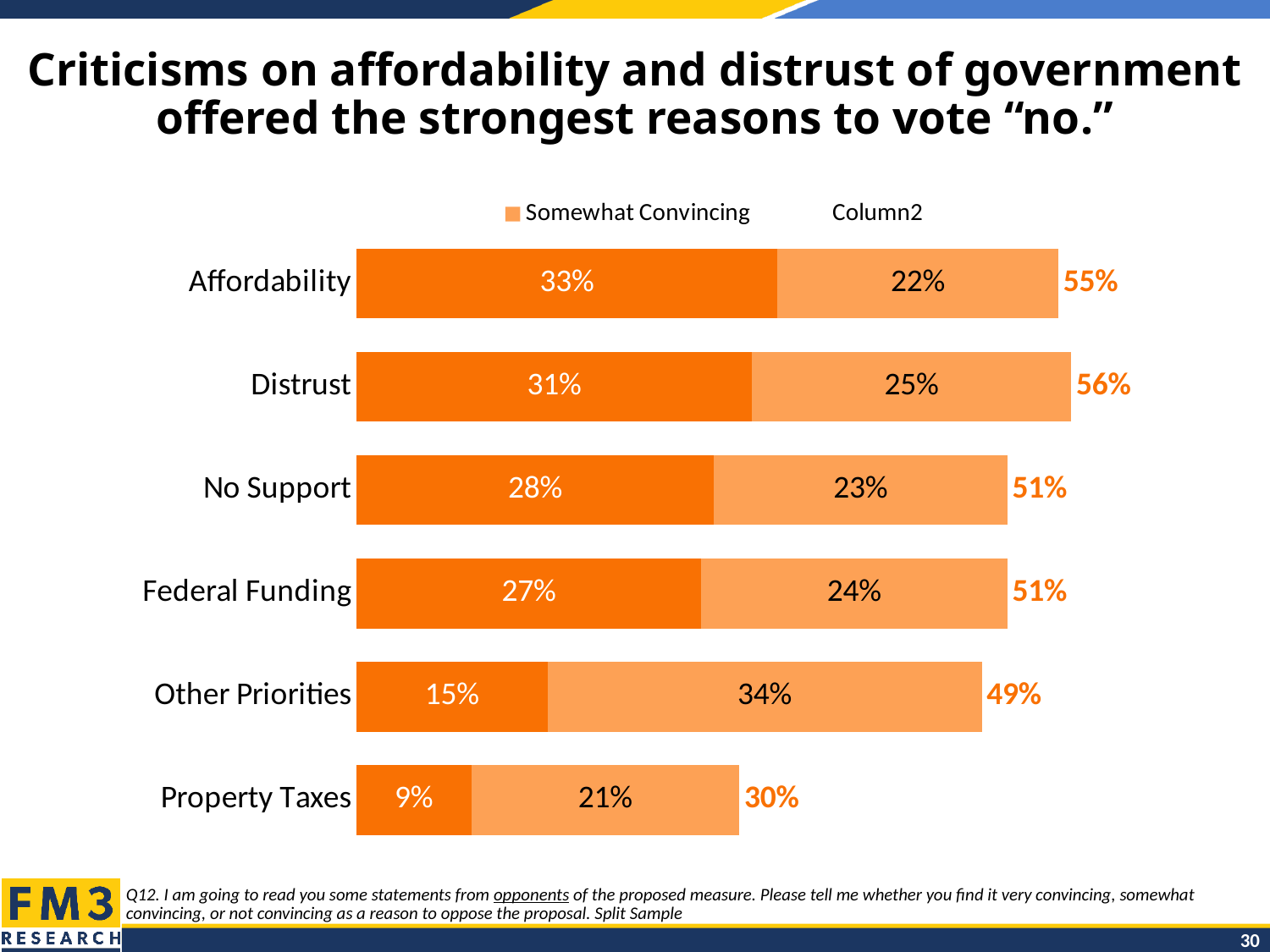
Which category has the largest darker orange segment? Affordability How many categories are plotted in the chart? 6 Which is larger: the Somewhat Convincing value for Other Priorities or for Affordability? Other Priorities What is the total value shown at the end of the Affordability bar? 55% Which category has the highest total value? Distrust What are the two entries listed in the chart's legend? Somewhat Convincing and Column2 Which category has the lowest total value? Property Taxes What kind of chart is shown on the slide? bar chart What is the difference between the total for Affordability and the total for Property Taxes? 25 percentage points How many entries does the chart's legend list? 2 What is the Somewhat Convincing value for Other Priorities? 34% What is the value of the darker orange segment for Property Taxes? 9%